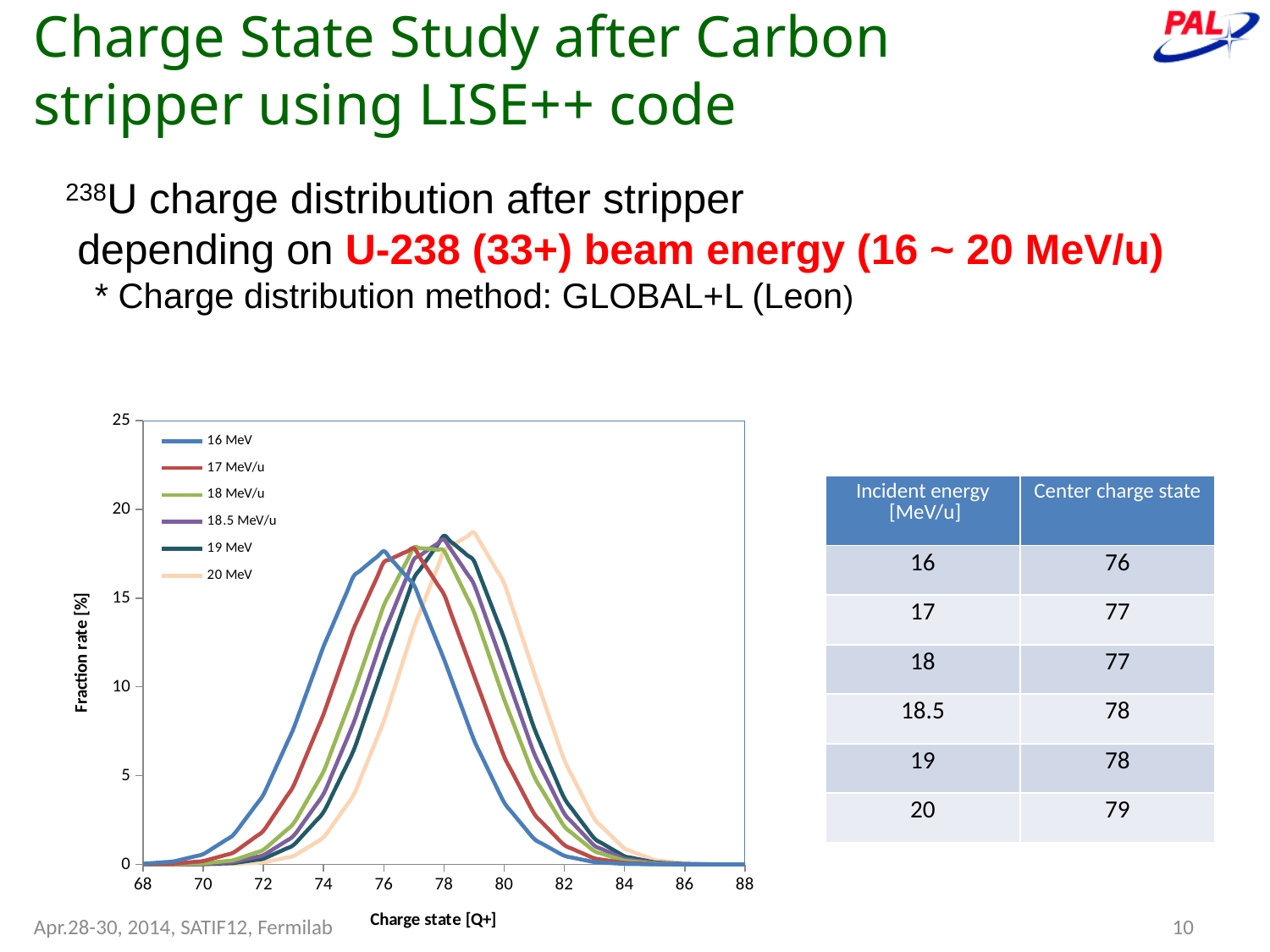
What is the label of the chart's y axis? Fraction rate [%] Which series has its peak at the highest charge state (furthest right on the x axis)? 20 MeV Is the value for the 20 MeV series at charge state 79 greater or less than 15? greater Which series has its peak at the lowest charge state (furthest left on the x axis)? 16 MeV Is the value for the 20 MeV series at charge state 74 greater or less than 5? less At charge state 74, which series has the larger value: 16 MeV or 20 MeV? 16 MeV Is the value for the 18 MeV/u series at charge state 72 greater or less than 5? less What kind of chart is shown on the slide? line chart How many series does the chart legend list? 6 What is the label of the chart's x axis? Charge state [Q+]